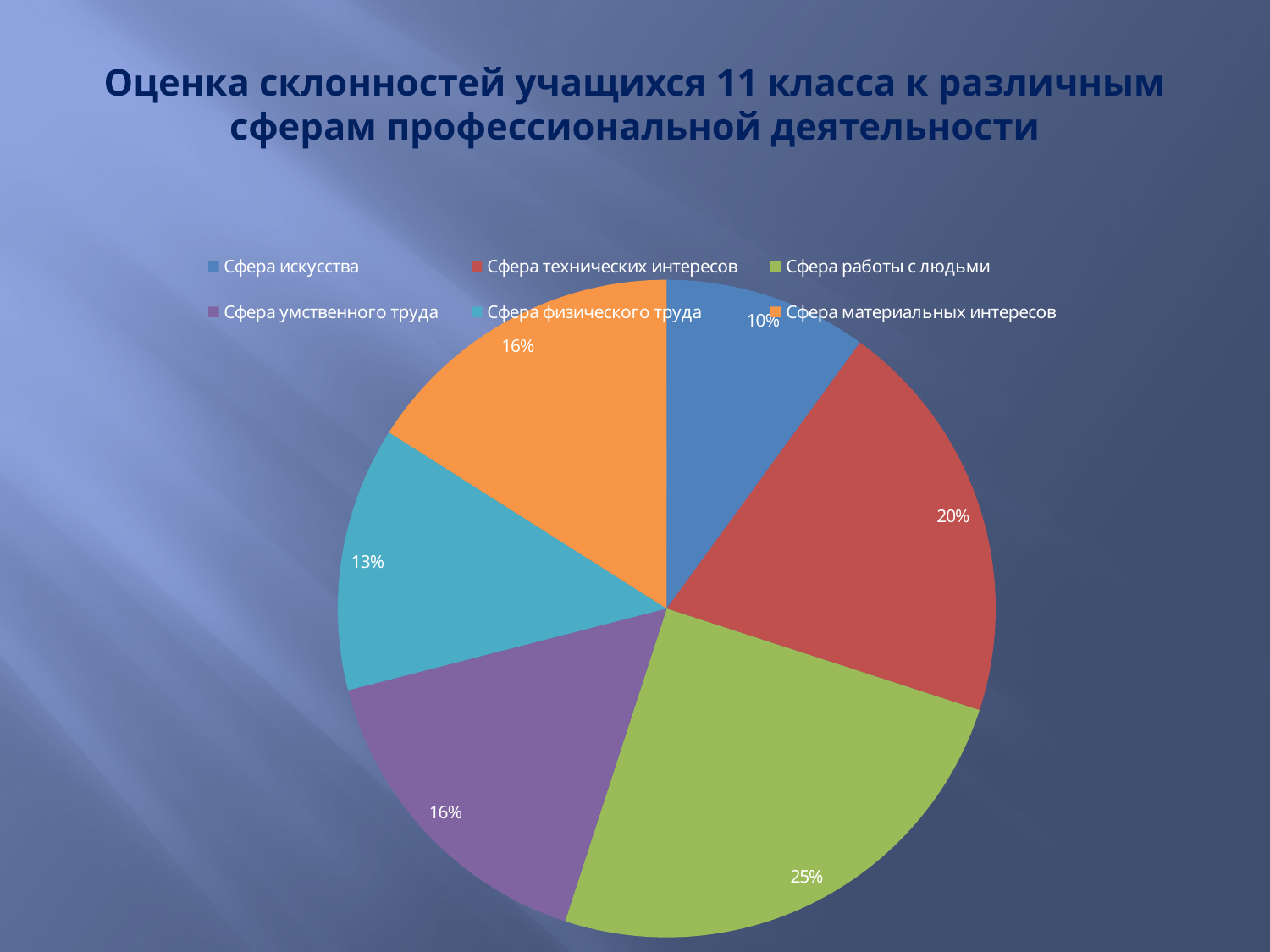
What percentage is shown for Сфера умственного труда? 16% What kind of chart is shown on the slide? pie chart What percentage is shown for Сфера технических интересов? 20% How many categories does the pie chart have? 6 Which category has the largest share of the pie? Сфера работы с людьми Which category has the smallest share of the pie? Сфера искусства What percentage is shown for Сфера работы с людьми? 25% Which is larger, the share for Сфера технических интересов or the share for Сфера физического труда? Сфера технических интересов What colour is the slice for Сфера материальных интересов? orange What percentage is shown for Сфера физического труда? 13% What percentage is shown for Сфера искусства? 10% What is the difference in percentage points between Сфера работы с людьми and Сфера искусства? 15